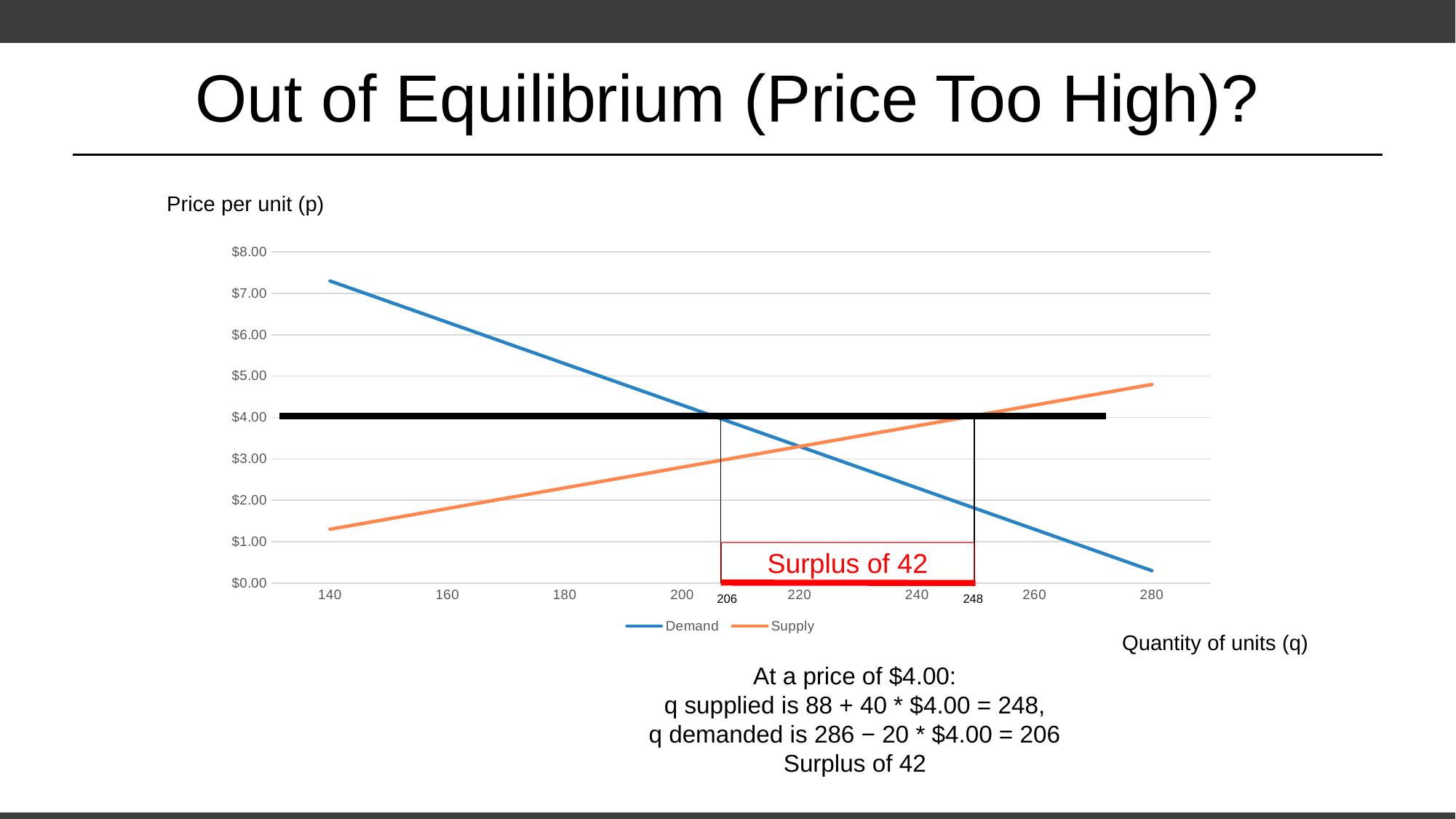
At a quantity of 140, which line shows the higher price, Demand or Supply? Demand What are the two series named in the chart's legend? Demand and Supply Is the Demand price at a quantity of 280 greater or less than $1.00? less Does the Supply line rise or fall as quantity increases along the x axis? rise What kind of chart is shown on the slide? line chart Is the Demand price at a quantity of 140 greater or less than $7.00? greater How many series does the chart's legend list? 2 Does the Demand line rise or fall as quantity increases along the x axis? fall At a price of $4.00, what is the quantity supplied shown on the chart? 248 What is the difference between quantity supplied and quantity demanded at a price of $4.00? 42 At a price of $4.00, what is the quantity demanded shown on the chart? 206 What is the label on the chart's horizontal axis? Quantity of units (q)